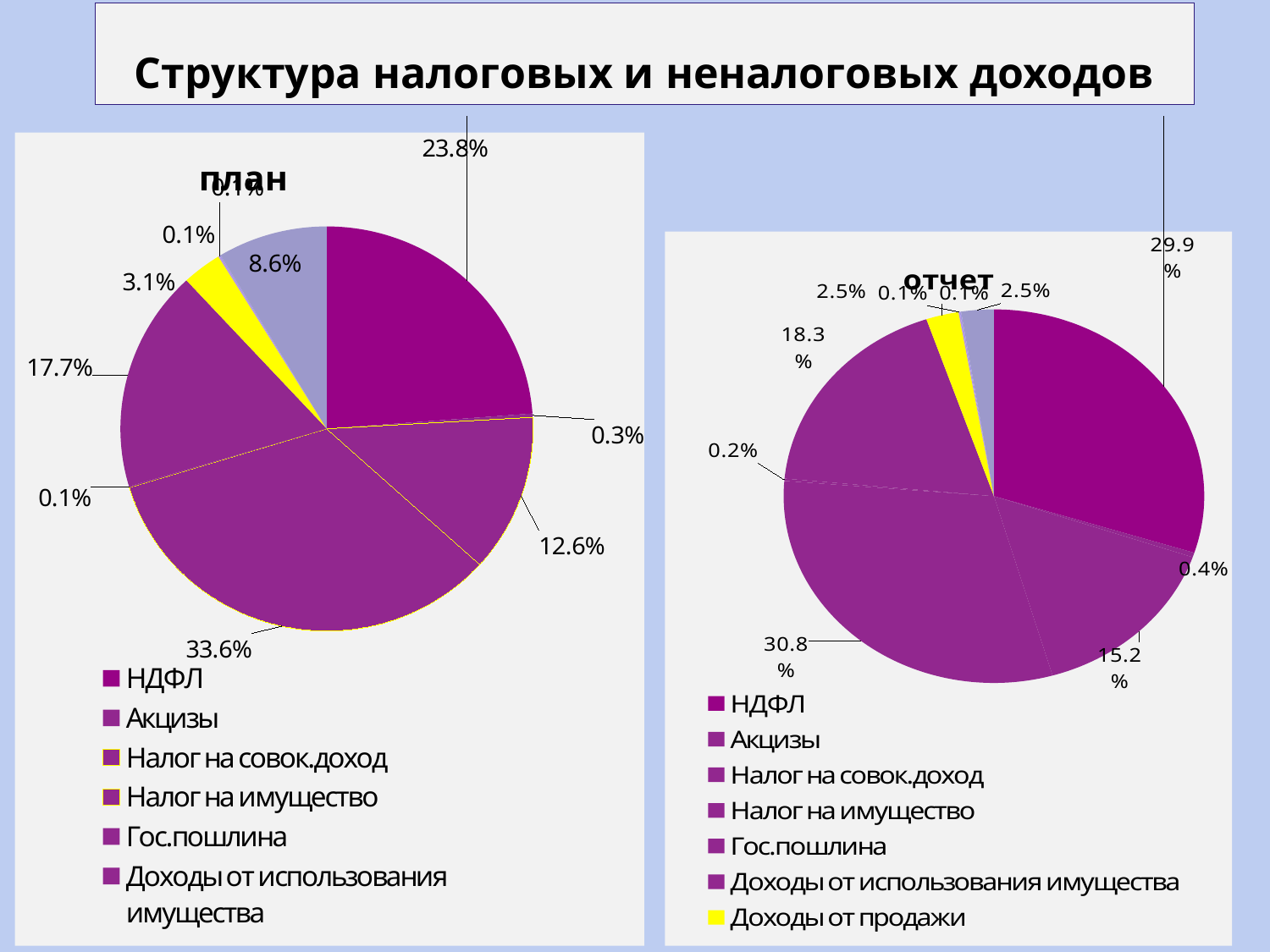
What kind of chart is the "план" chart? pie chart Which is larger: the largest slice in the "план" chart or the largest slice in the "отчет" chart? the largest slice in the "план" chart (33.6%) In the "отчет" chart, what is the largest slice's share? 30.8% In the "план" chart, what share does НДФЛ have? 23.8% In the "отчет" chart, what share does НДФЛ have? 29.9% By how many percentage points is the НДФЛ share in the "отчет" chart larger than in the "план" chart? 6.1 In the "отчет" chart, what share does Доходы от продажи (the yellow slice) have? 2.5% How many entries does the legend of the "отчет" chart list? 7 What is the title of the slide? Структура налоговых и неналоговых доходов In the "план" chart, what is the largest slice's share? 33.6% What kind of chart is the "отчет" chart? pie chart